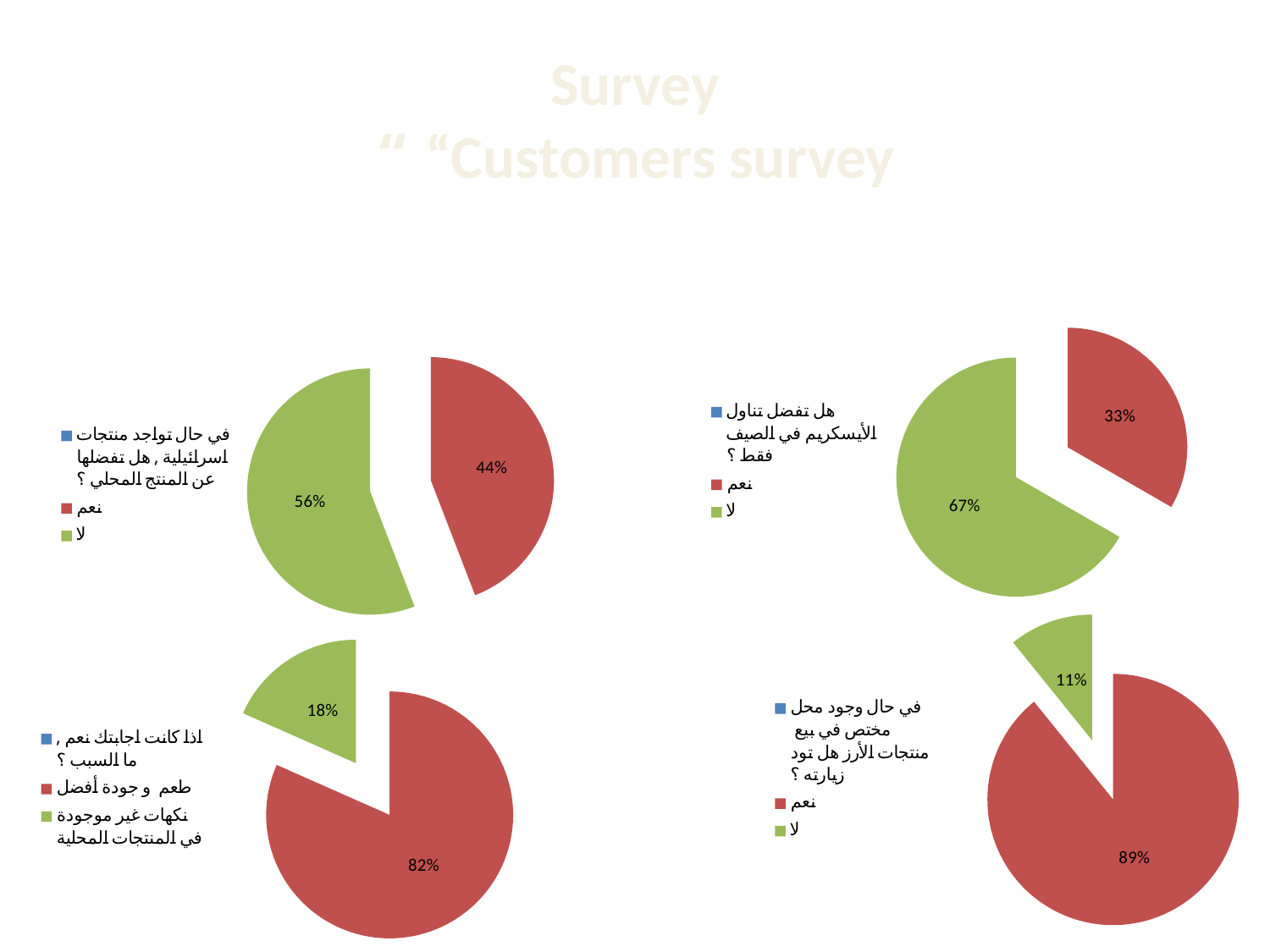
In the bottom-right pie chart, what percentage is shown for the green slice (لا)? 11% In the top-right pie chart, what percentage is shown for the green slice (لا)? 67% In the top-left pie chart, what percentage is shown for the green slice (لا)? 56% In the top-right pie chart, what is the difference between the green slice (67%) and the red slice (33%)? 34% In the top-right pie chart, what percentage is shown for the red slice (نعم)? 33% In the top-left pie chart, which is larger, the red slice (نعم) or the green slice (لا)? لا (56%) What type of chart is used in the bottom-right of the slide? Pie chart In the bottom-right pie chart, which slice is the largest? نعم (89%) In the bottom-left pie chart, which slice is the smallest? نكهات غير موجودة في المنتجات المحلية (18%) In the top-left pie chart, what percentage is shown for the red slice (نعم)? 44% How many pie charts are shown on the slide? 4 In the bottom-left pie chart, what percentage is shown for the red slice (طعم و جودة أفضل)? 82%